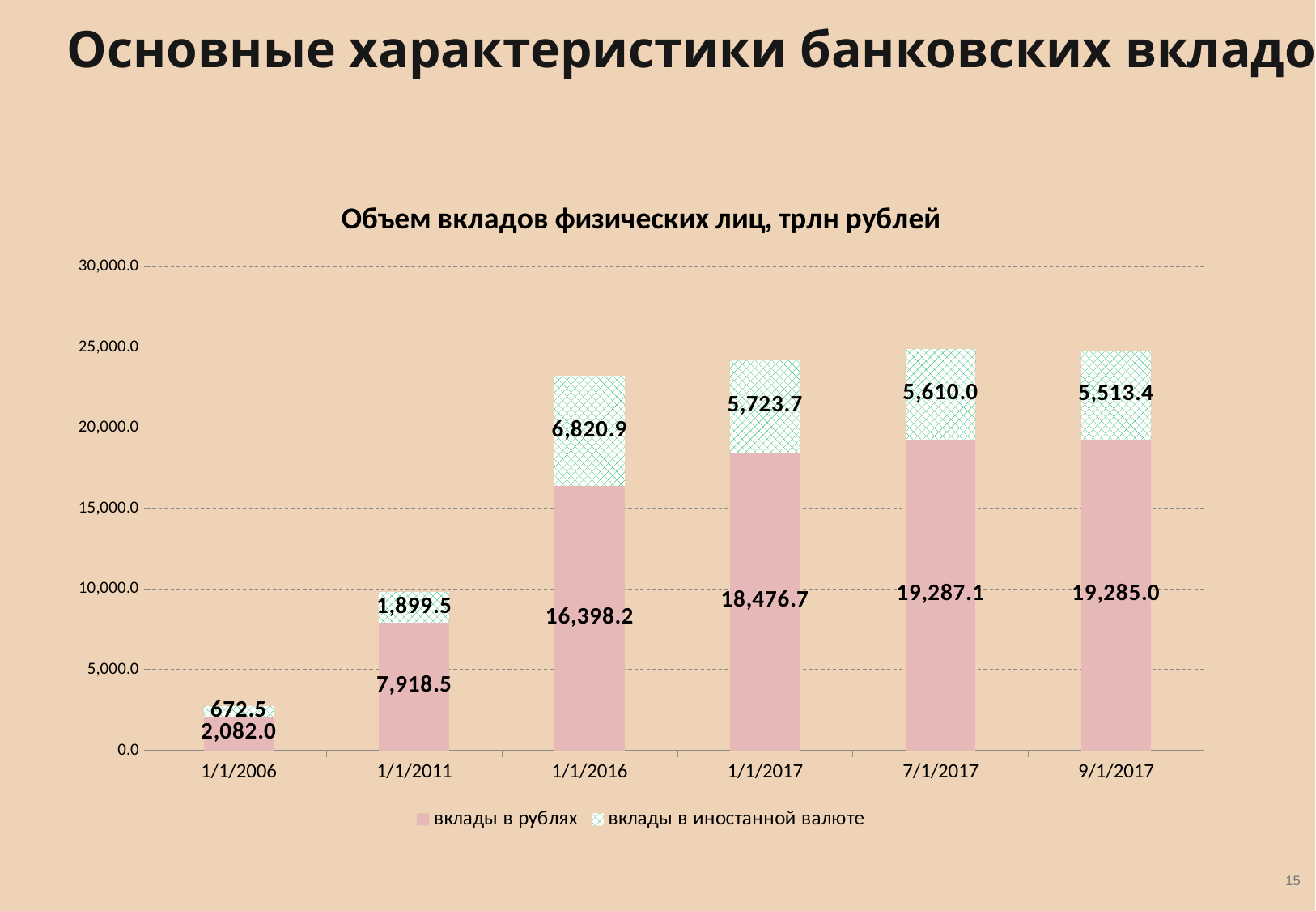
What is the value of вклады в рублях for 1/1/2016? 16,398.2 What is the value of вклады в иностанной валюте for 1/1/2011? 1,899.5 Which date has the highest value for вклады в иностанной валюте? 1/1/2016 What is the value of вклады в иностанной валюте for 9/1/2017? 5,513.4 Which date has the lowest value for вклады в рублях? 1/1/2006 What kind of chart is shown on the slide? stacked bar chart What is the difference between вклады в иностанной валюте for 1/1/2016 and 1/1/2017? 1,097.2 Is the total stacked bar for 1/1/2016 greater or less than 20,000.0? greater Which is larger: вклады в рублях for 1/1/2011 or вклады в иностанной валюте for 1/1/2016? вклады в рублях for 1/1/2011 How many dates are shown on the x axis? 6 How many series does the legend list? 2 What is the total of the stacked bar for 1/1/2006? 2,754.5